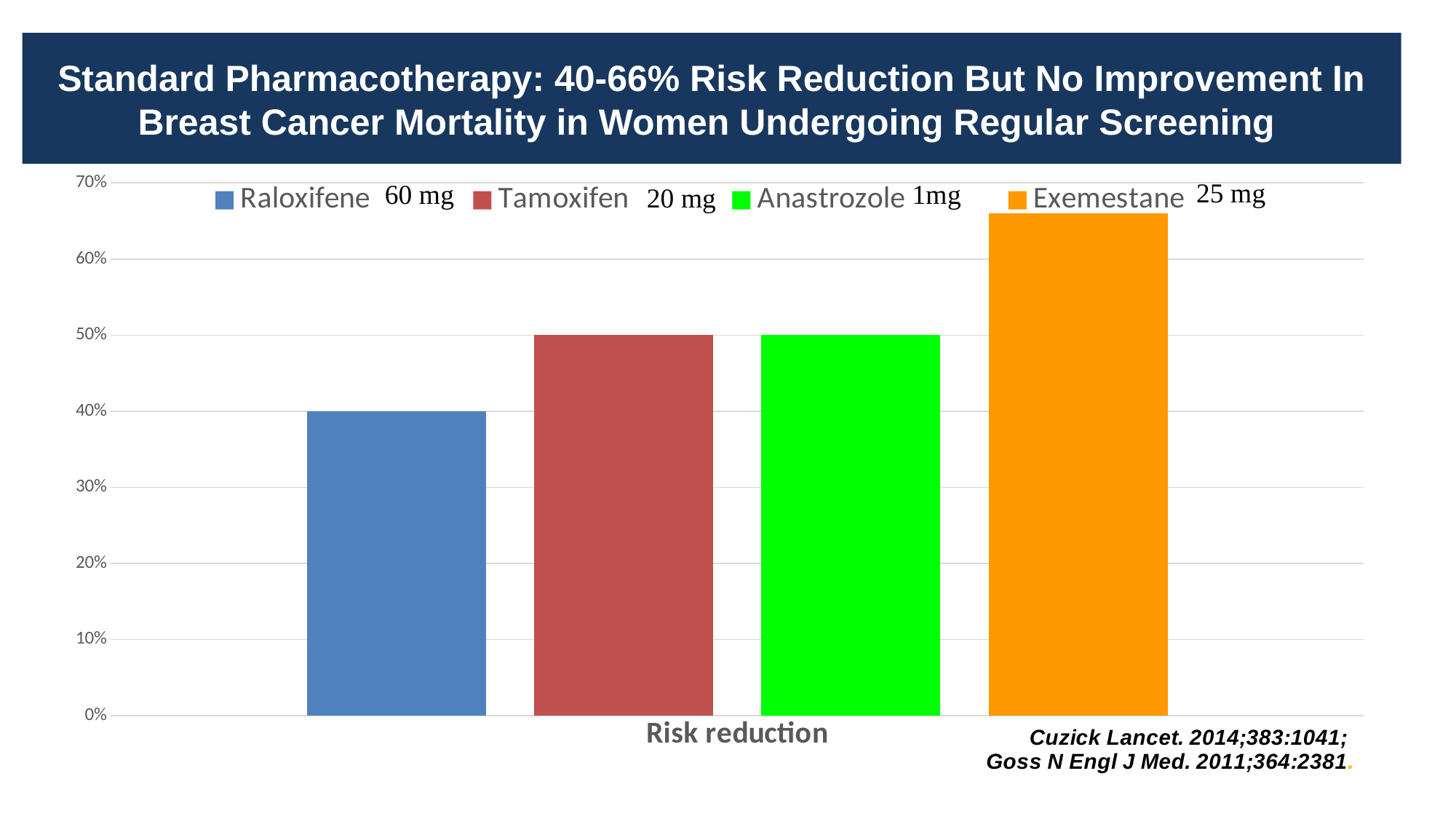
Which has a larger risk reduction, Raloxifene or Tamoxifen? Tamoxifen How many bars are plotted in the chart? 4 What is the risk reduction value for Anastrozole? 50% Which drug shows the lowest risk reduction? Raloxifene Which drug shows the highest risk reduction? Exemestane What is the risk reduction value for Tamoxifen? 50% What kind of chart is shown on the slide? Bar chart Is the risk reduction for Exemestane greater or less than 60%? greater How many series does the legend list? 4 What is the risk reduction value for Raloxifene? 40% What is the difference in risk reduction between Tamoxifen and Raloxifene? 10 percentage points What colour is the Exemestane bar? Orange